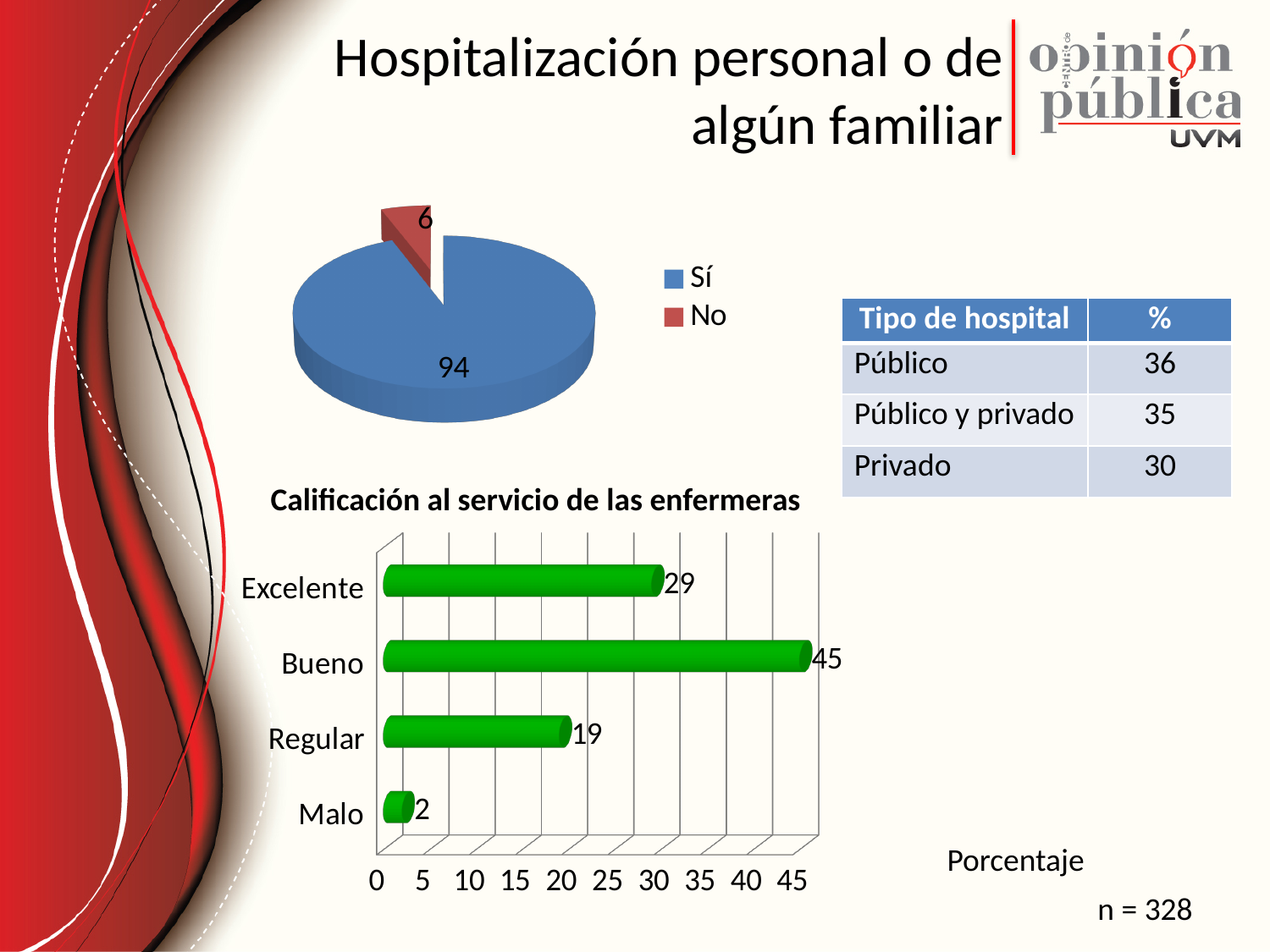
In the chart "Calificación al servicio de las enfermeras", what is the value for "Regular"? 19 In the pie chart at the top of the slide, what is the value for "No"? 6 In the pie chart at the top of the slide, what is the value for "Sí"? 94 How many categories are shown in the chart "Calificación al servicio de las enfermeras"? 4 What kind of chart is "Calificación al servicio de las enfermeras"? Bar chart In the chart "Calificación al servicio de las enfermeras", what is the difference between the values for "Bueno" and "Excelente"? 16 In the pie chart at the top of the slide, how many entries does the legend list? 2 What kind of chart is the chart at the top of the slide? Pie chart In the chart "Calificación al servicio de las enfermeras", what is the value for "Bueno"? 45 In the chart "Calificación al servicio de las enfermeras", which category has the highest value? Bueno In the chart "Calificación al servicio de las enfermeras", which category has the lowest value? Malo In the pie chart at the top of the slide, which slice is larger, "Sí" or "No"? Sí